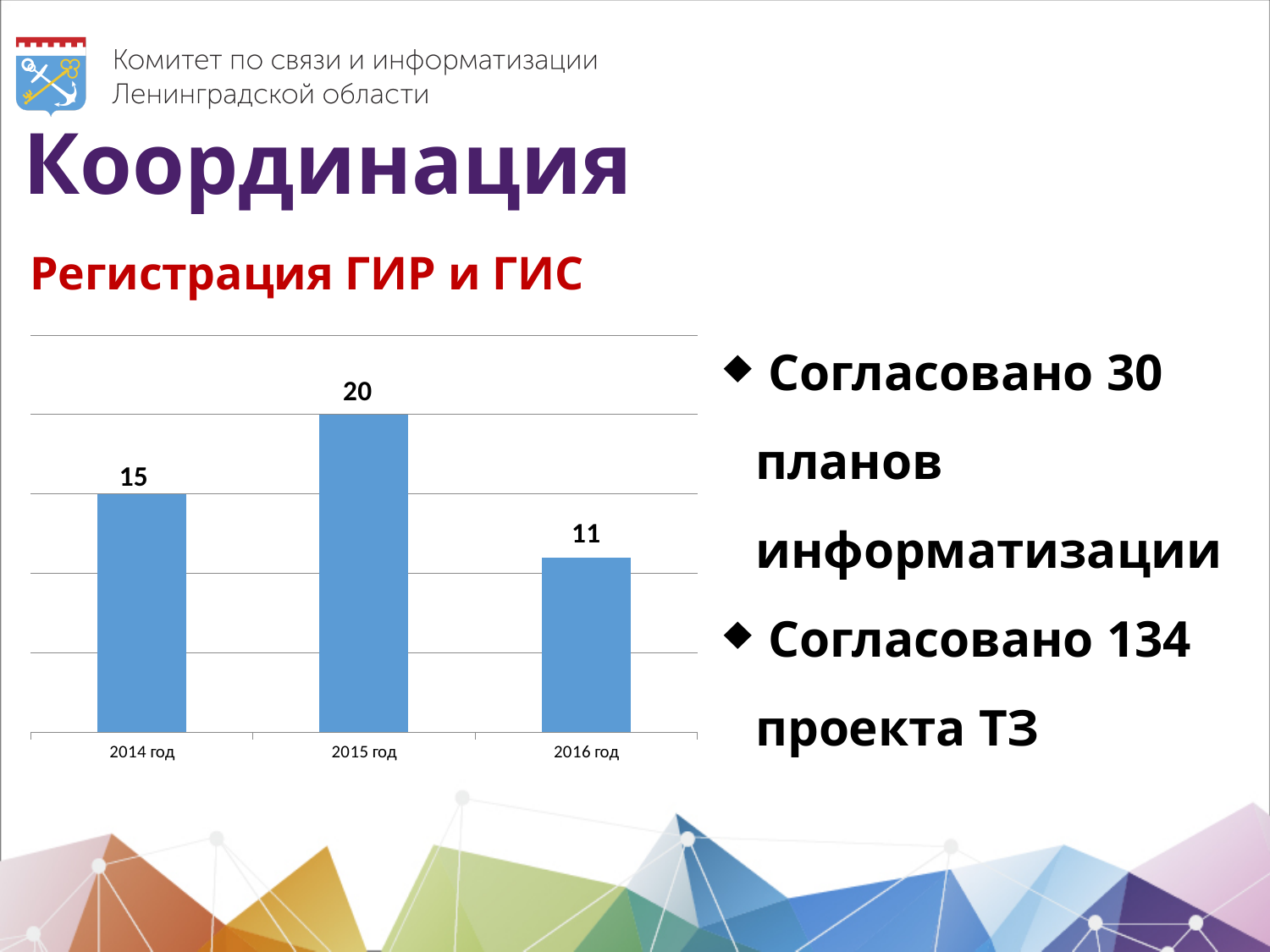
What is the difference between the values for 2015 год and 2016 год? 9 Which year has the lowest value? 2016 год What kind of chart is shown on the slide? bar chart What is the value for 2015 год? 20 What is the title above the chart? Регистрация ГИР и ГИС What is the value for 2014 год? 15 Which year has the highest value? 2015 год What is the difference between the values for 2015 год and 2014 год? 5 Do the values rise or fall from 2015 год to 2016 год? fall What is the value for 2016 год? 11 How many categories are shown on the x axis? 3 Which is larger, the value for 2014 год or the value for 2016 год? 2014 год